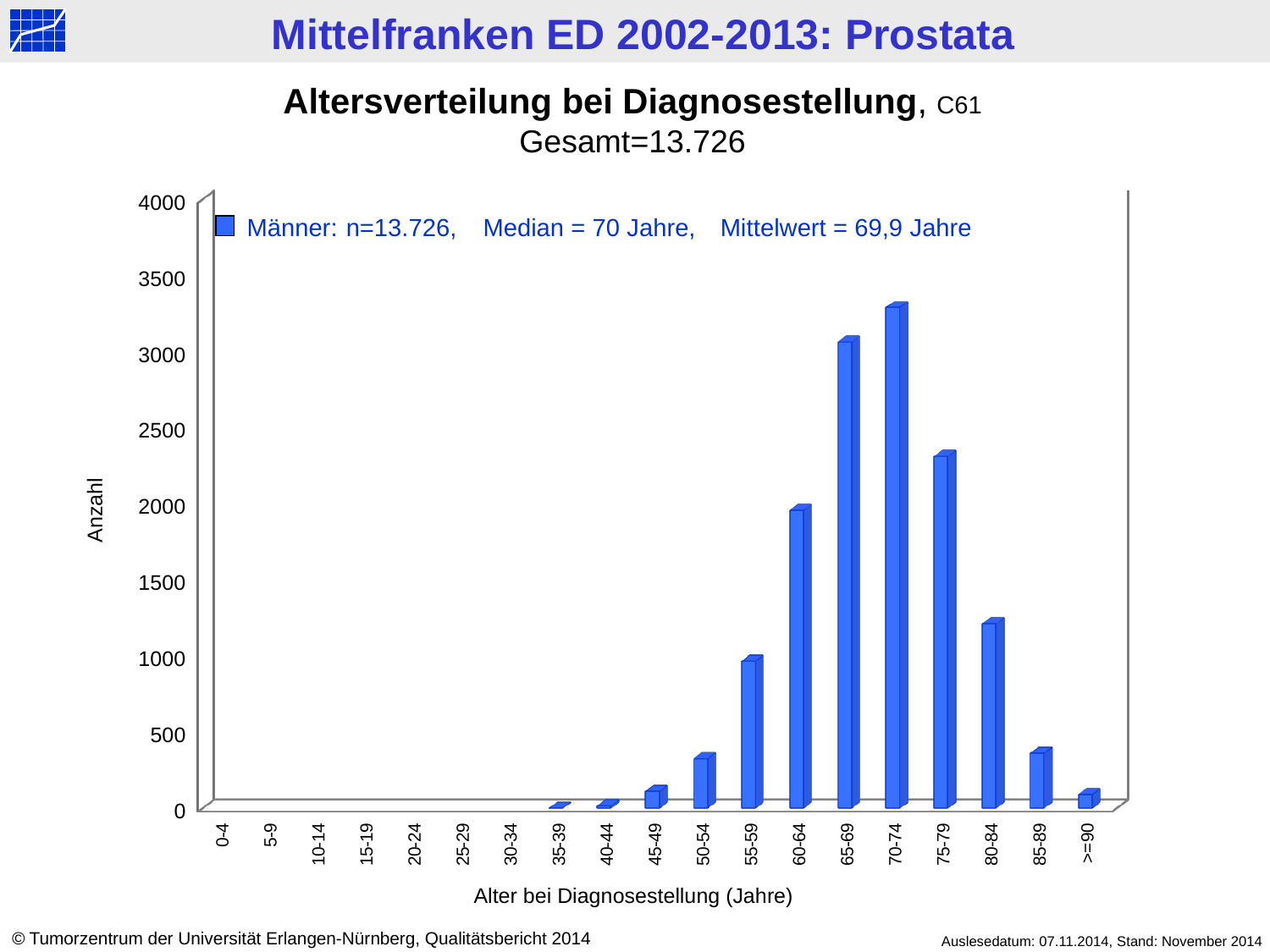
Is the value for the 50-54 age group greater or less than 500? less Is the value for the 70-74 age group greater or less than 3000? greater What kind of chart is shown on the slide? bar chart Do the values rise or fall from the 70-74 age group to the >=90 age group? fall How many age-group categories are shown on the x axis? 19 What median age is stated in the legend? 70 Jahre How many series does the legend list? 1 Which age group has the highest number of diagnoses? 70-74 Which age group has the larger value, 65-69 or 75-79? 65-69 Is the value for the 75-79 age group greater or less than 2000? greater